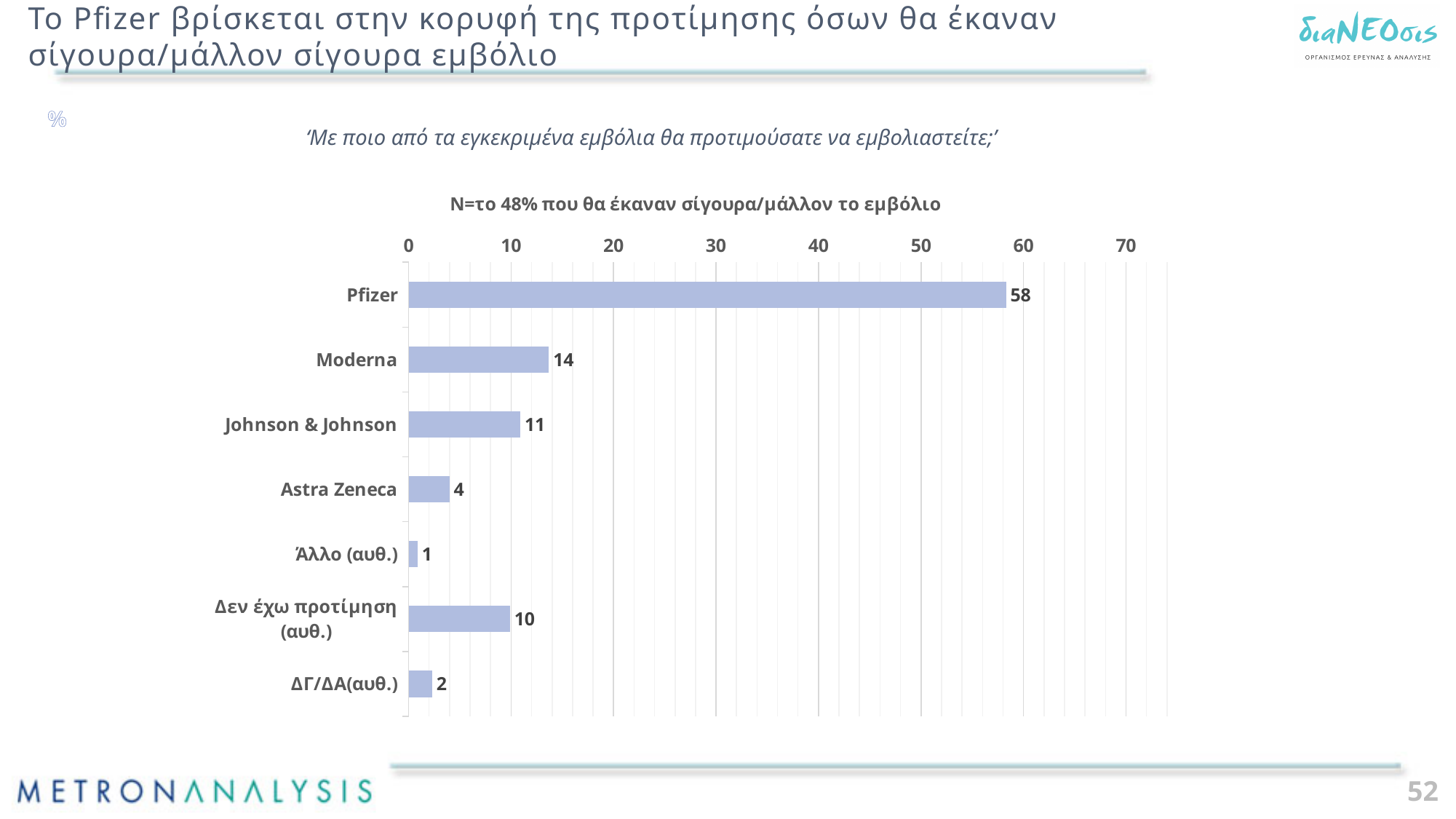
Which is larger, the value for Johnson & Johnson or the value for Δεν έχω προτίμηση (αυθ.)? Johnson & Johnson How many categories are shown in the chart? 7 What is the value for Moderna? 14 What is the difference between the values for Pfizer and Moderna? 44 What kind of chart is shown on the slide? Bar chart What is the value for Astra Zeneca? 4 What is the value for Pfizer? 58 What is the value for Δεν έχω προτίμηση (αυθ.)? 10 Which category has the highest value? Pfizer Which category has the lowest value? Άλλο (αυθ.) What is the value for Johnson & Johnson? 11 What is the chart's title? N=το 48% που θα έκαναν σίγουρα/μάλλον το εμβόλιο